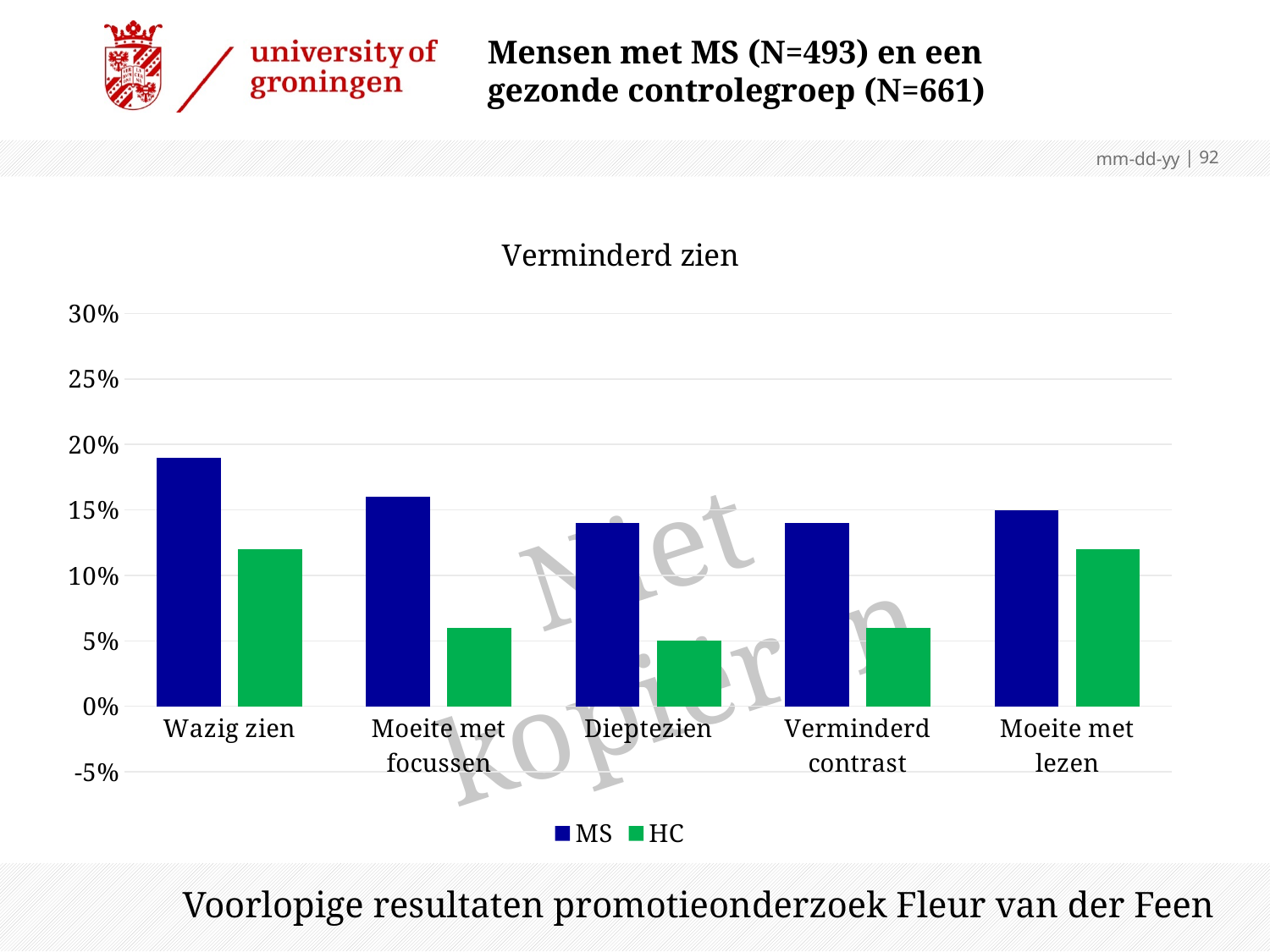
What is the title of the chart? Verminderd zien For Verminderd contrast, which series has the larger value, MS or HC? MS Is the MS value for Moeite met lezen greater or less than 20%? less How many series does the legend list? 2 Is the HC value for Moeite met focussen greater or less than 10%? less Is the MS value for Wazig zien greater or less than 15%? greater What kind of chart is shown on the slide? bar chart How many categories are shown on the x axis? 5 Which is larger for the HC series: Wazig zien or Moeite met focussen? Wazig zien Which category has the highest value for the MS series? Wazig zien